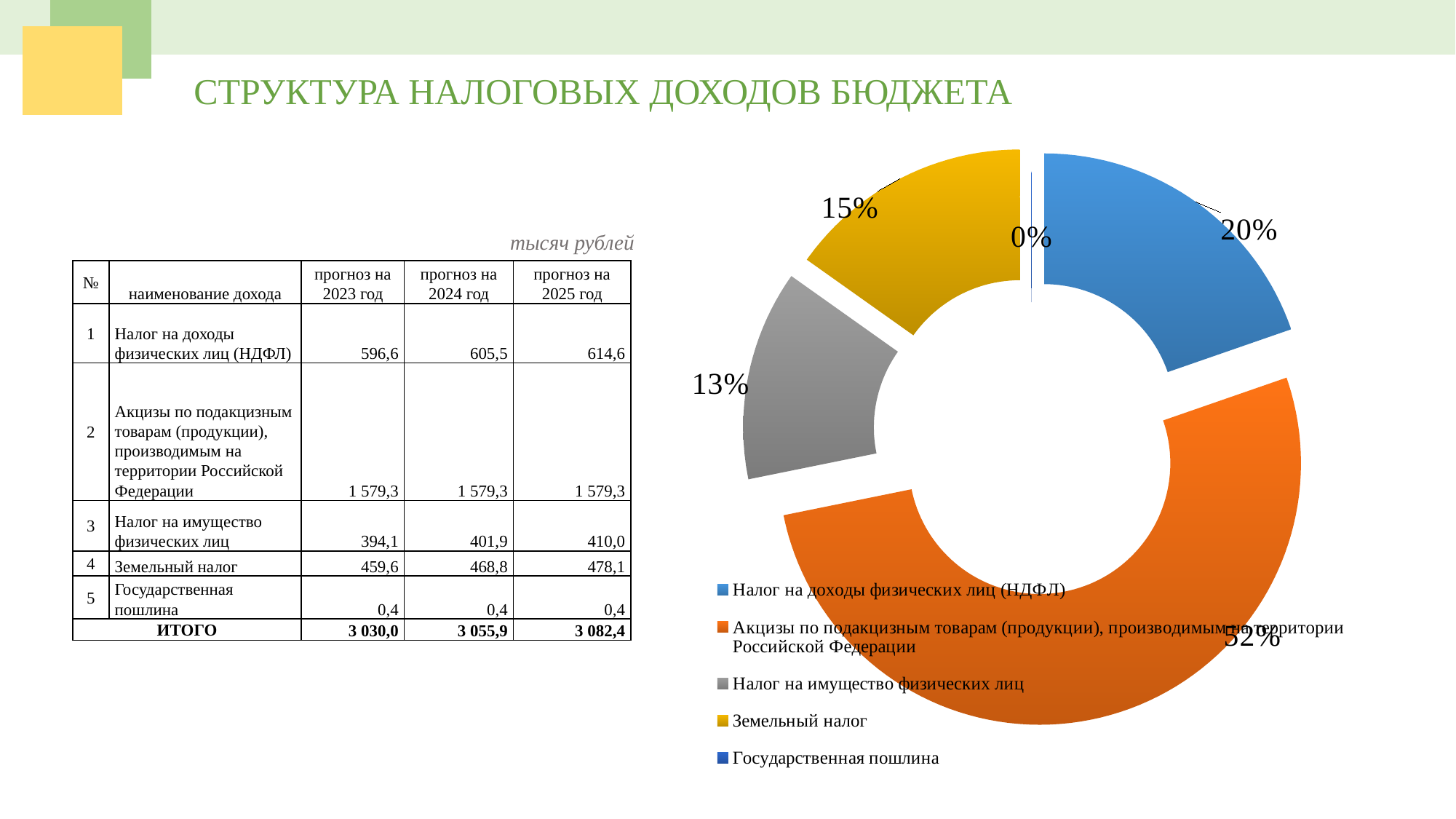
Which category has the largest share in the doughnut chart? Акцизы по подакцизным товарам (продукции), производимым на территории Российской Федерации How many categories does the legend of the doughnut chart list? 5 What share of the doughnut chart does Налог на доходы физических лиц (НДФЛ) have? 20% What share of the doughnut chart does Государственная пошлина have? 0% What share of the doughnut chart does Акцизы по подакцизным товарам (продукции), производимым на территории Российской Федерации have? 52% What colour is the segment for Налог на имущество физических лиц in the doughnut chart? Gray What kind of chart is shown on the slide? Doughnut (pie) chart What is the difference in percentage points between the share of Акцизы and the share of НДФЛ in the doughnut chart? 32 percentage points Which category has the smallest share in the doughnut chart? Государственная пошлина Which has a larger share in the doughnut chart: Земельный налог or Налог на имущество физических лиц? Земельный налог